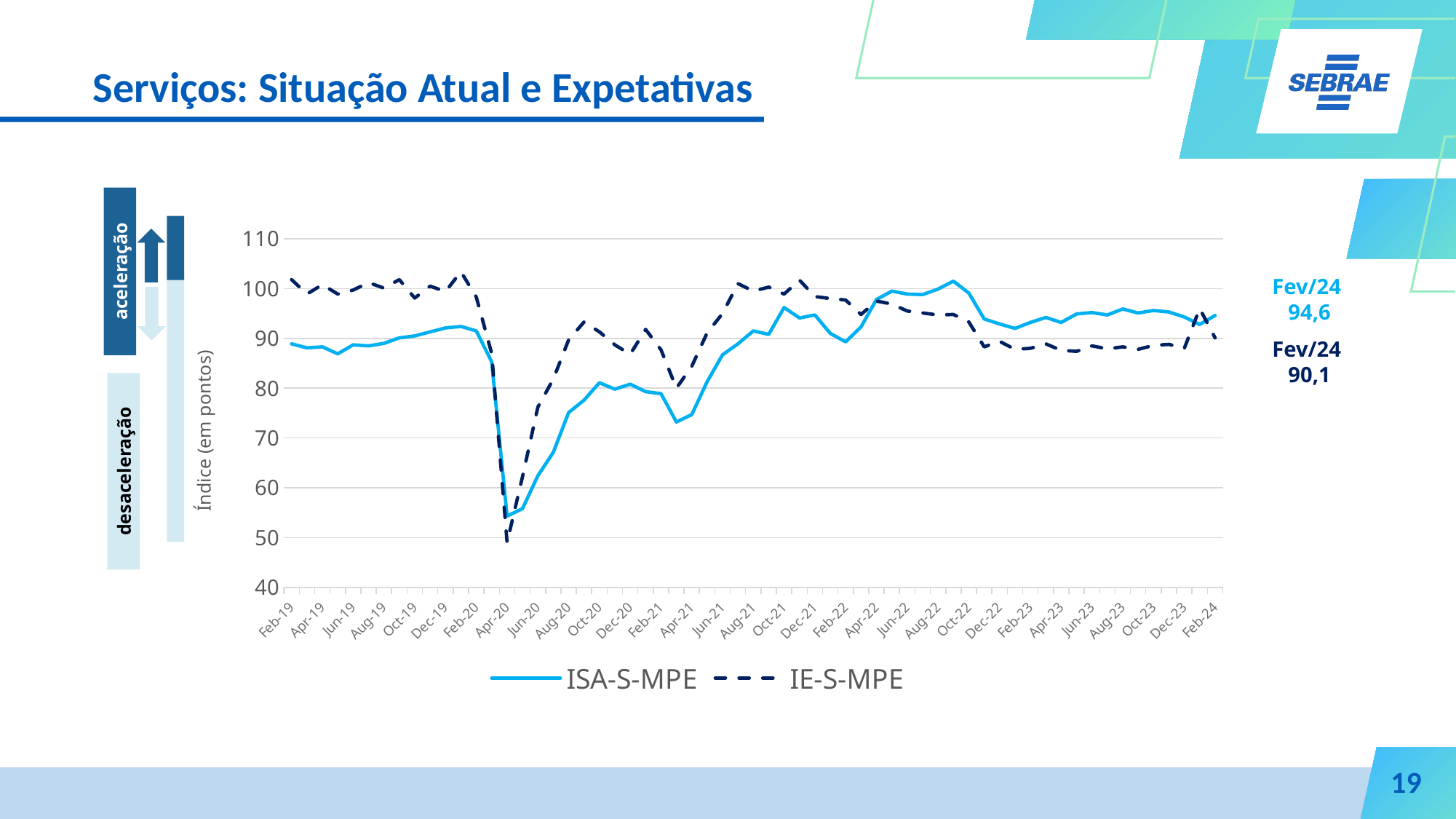
Is the value for ISA-S-MPE in Apr-21 greater or less than 80? less Does the ISA-S-MPE line rise or fall between Feb-20 and Apr-20? fall How many series does the legend list? 2 What is the value of IE-S-MPE in Fev/24? 90,1 Which series has the higher value in Fev/24, ISA-S-MPE or IE-S-MPE? ISA-S-MPE What is the value of ISA-S-MPE in Fev/24? 94,6 What is the label of the vertical axis? Índice (em pontos) Is the value for ISA-S-MPE in Apr-20 greater or less than 60? less Which series is drawn with a dashed line? IE-S-MPE What kind of chart is shown on the slide? line chart Which series reaches the lower point in Apr-20, ISA-S-MPE or IE-S-MPE? IE-S-MPE What is the difference between ISA-S-MPE and IE-S-MPE in Fev/24? 4,5